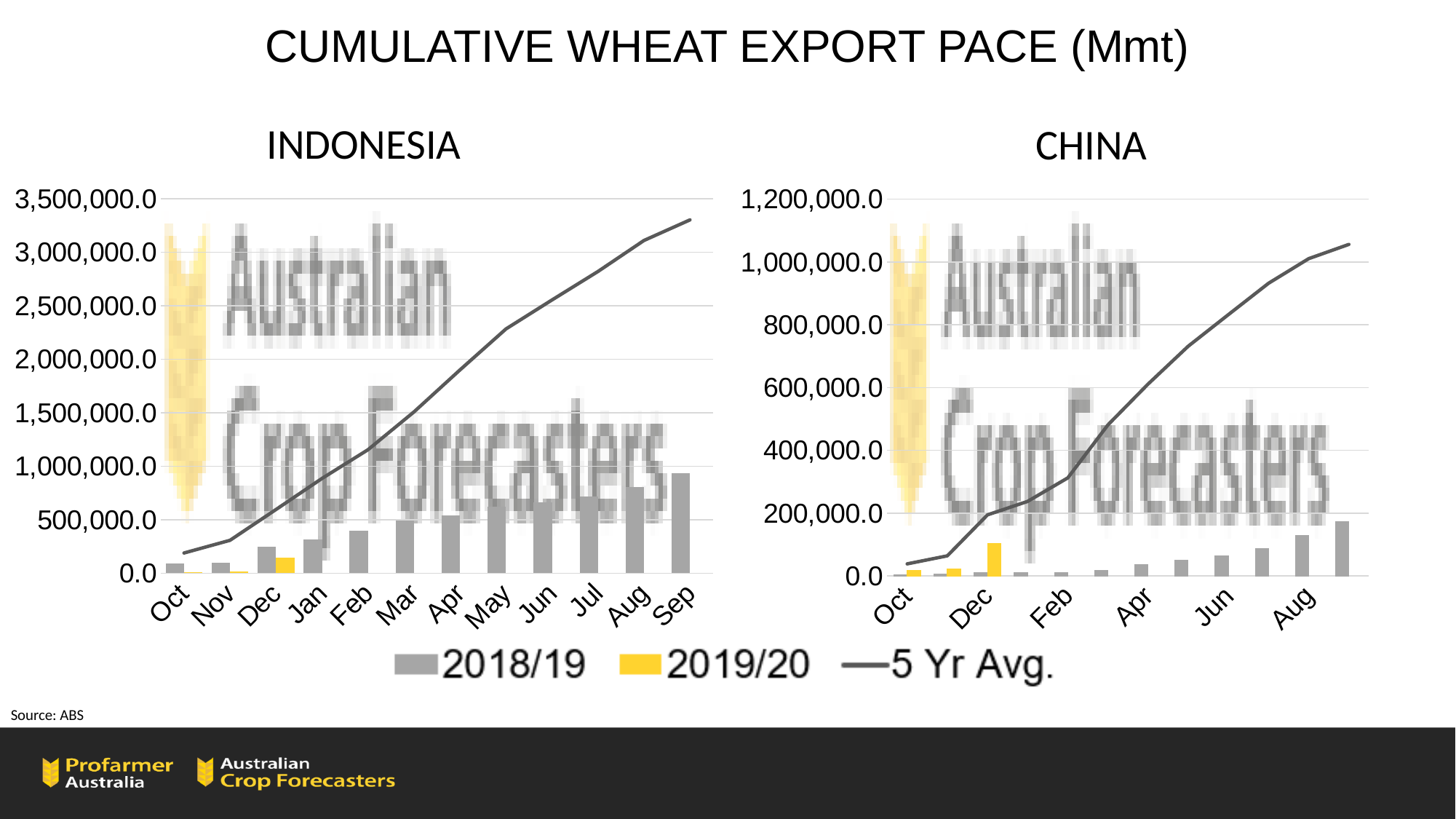
On the CHINA chart, is the 5 Yr Avg value for Jun greater or less than 800,000.0? greater What kind of chart is the INDONESIA chart? A bar chart with a line On the INDONESIA chart, does the 5 Yr Avg line rise or fall from Oct to Sep? Rises On the CHINA chart, is the 2018/19 value for Aug greater or less than 200,000.0? less On the INDONESIA chart, is the 2018/19 value for Sep greater or less than 500,000.0? greater On the INDONESIA chart, which month has the highest 2018/19 bar? Sep On the INDONESIA chart, how many months are shown on the x axis? 12 On the CHINA chart, in Dec, which is larger: the 2018/19 bar or the 2019/20 bar? 2019/20 How many series does the legend list? 3 On the INDONESIA chart, in Dec, which is larger: the 2018/19 bar or the 2019/20 bar? 2018/19 What colour are the 2019/20 bars in the legend? Yellow